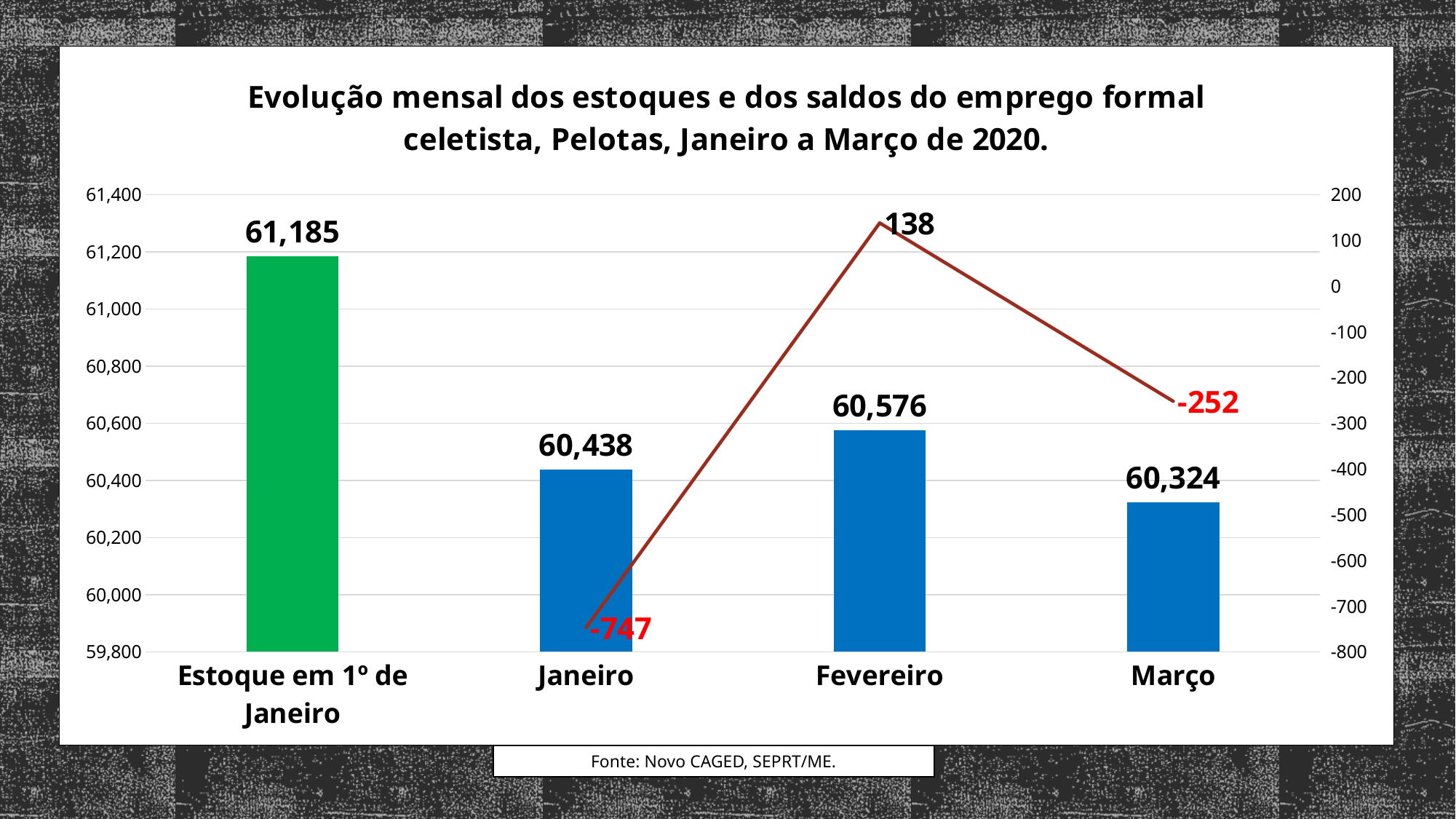
What kind of chart is this? Combined bar and line chart What is the value of the line (saldo) at Março? -252 Is the line value for Fevereiro greater or less than 0? greater Which is larger, the bar for Janeiro or the bar for Março? Janeiro What is the difference between the bar values for Fevereiro and Janeiro? 138 What is the value of the bar for Estoque em 1º de Janeiro? 61,185 Which category has the highest bar? Estoque em 1º de Janeiro What is the value of the line (saldo) at Janeiro? -747 How many bars are shown in the chart? 4 What is the value of the bar for Fevereiro? 60,576 Which category has the lowest bar? Março What colour is the bar for Estoque em 1º de Janeiro? Green